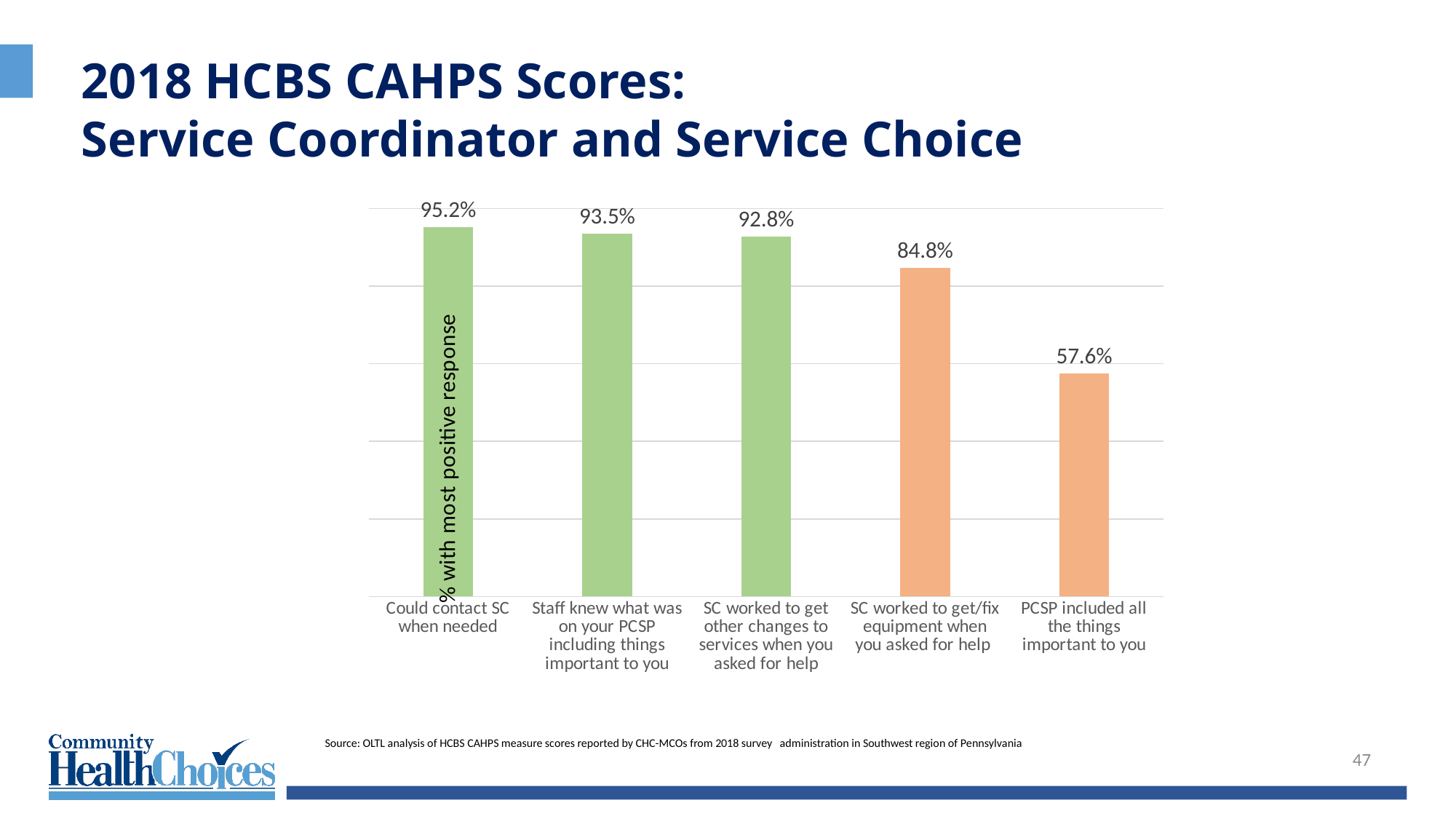
What is the difference between "SC worked to get other changes to services when you asked for help" and "SC worked to get/fix equipment when you asked for help"? 8.0% What is the value for "Could contact SC when needed"? 95.2% What is the difference between "Could contact SC when needed" and "PCSP included all the things important to you"? 37.6% Which category has the lowest value? PCSP included all the things important to you What is the value for "SC worked to get/fix equipment when you asked for help"? 84.8% What is the value for "Staff knew what was on your PCSP including things important to you"? 93.5% How many categories are shown in the chart? 5 What is the label on the vertical axis of the chart? % with most positive response Which category has the highest value? Could contact SC when needed What is the value for "PCSP included all the things important to you"? 57.6% What kind of chart is shown on the slide? Bar chart Which is larger: "Staff knew what was on your PCSP including things important to you" or "SC worked to get/fix equipment when you asked for help"? Staff knew what was on your PCSP including things important to you